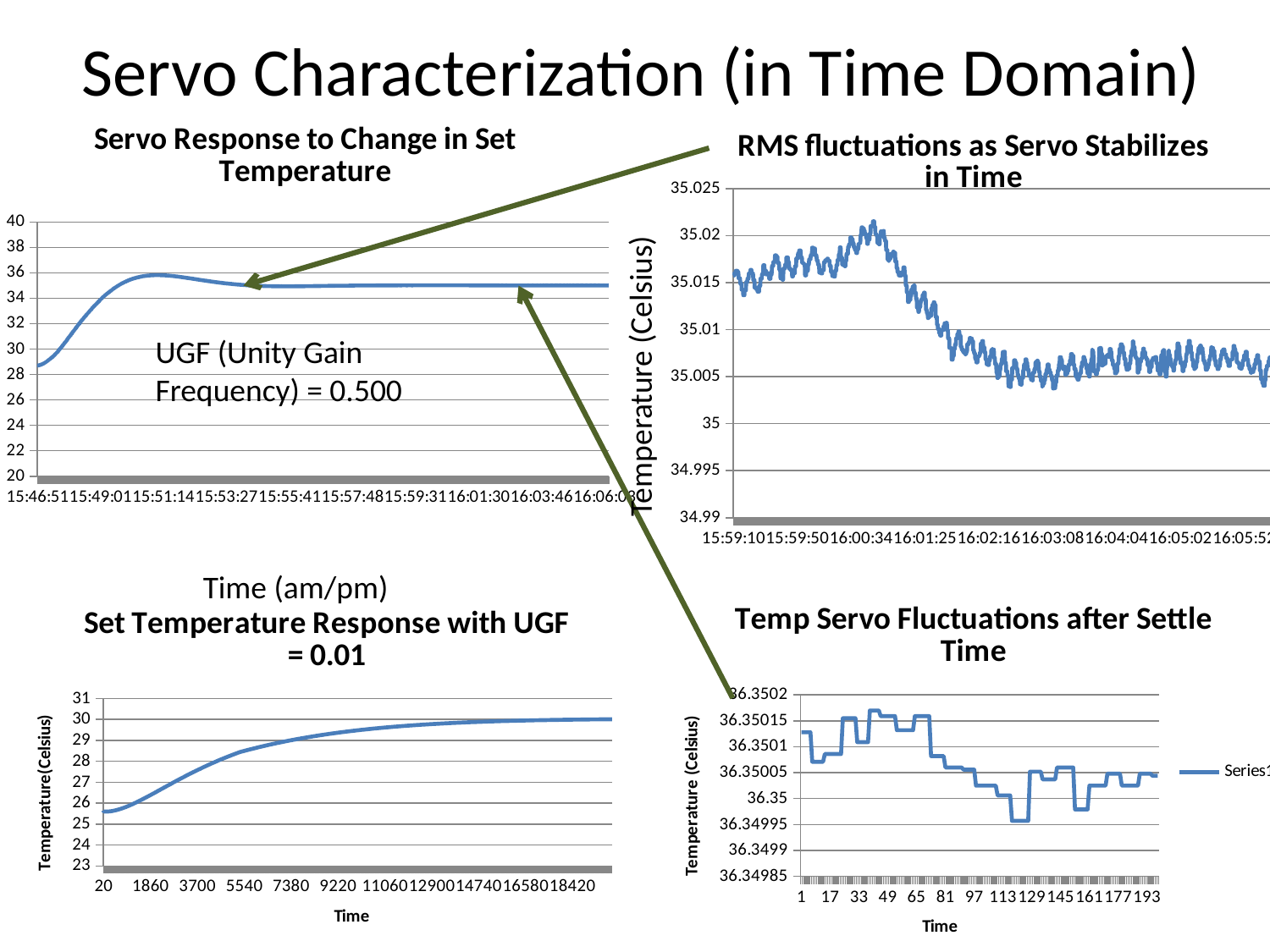
What kind of chart is the 'Servo Response to Change in Set Temperature' chart? line chart In the 'Set Temperature Response with UGF = 0.01' chart, do the values rise or fall along the x axis? rise How many series does the legend of the 'Temp Servo Fluctuations after Settle Time' chart list? 1 What is the y-axis title of the 'RMS fluctuations as Servo Stabilizes in Time' chart? Temperature (Celsius) How many charts are shown on the slide? 4 In the 'Servo Response to Change in Set Temperature' chart, is the value at 15:46:51 greater or less than 30? less In the 'Set Temperature Response with UGF = 0.01' chart, is the value at time 18420 greater or less than 29? greater What kind of chart is the 'Temp Servo Fluctuations after Settle Time' chart? line chart In the 'RMS fluctuations as Servo Stabilizes in Time' chart, do the values overall rise or fall along the x axis? fall In the 'Set Temperature Response with UGF = 0.01' chart, is the value at time 20 greater or less than 27? less